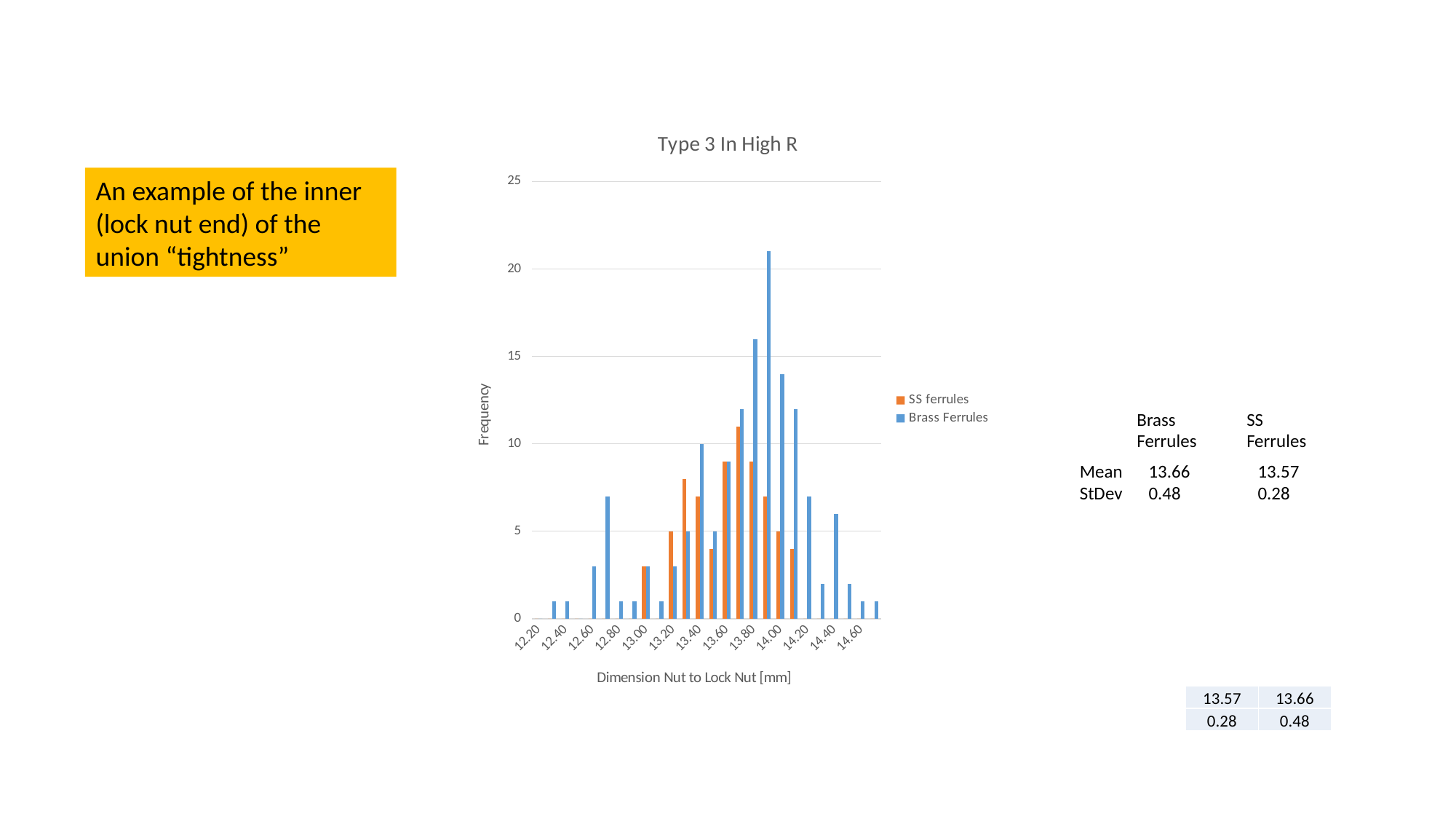
How many series does the legend of the chart list? 2 Is the tallest Brass Ferrules bar greater or less than 25? less How many tick labels are shown along the x axis of the chart? 13 Is the tallest SS ferrules bar greater or less than 15? less Is the tallest SS ferrules bar greater or less than 10? greater What is the title of the chart? Type 3 In High R What are the two series named in the chart legend? SS ferrules and Brass Ferrules Which series has the tallest bar in the chart, SS ferrules or Brass Ferrules? Brass Ferrules What kind of chart is shown on the slide? bar chart What is the highest value shown on the y axis of the chart? 25